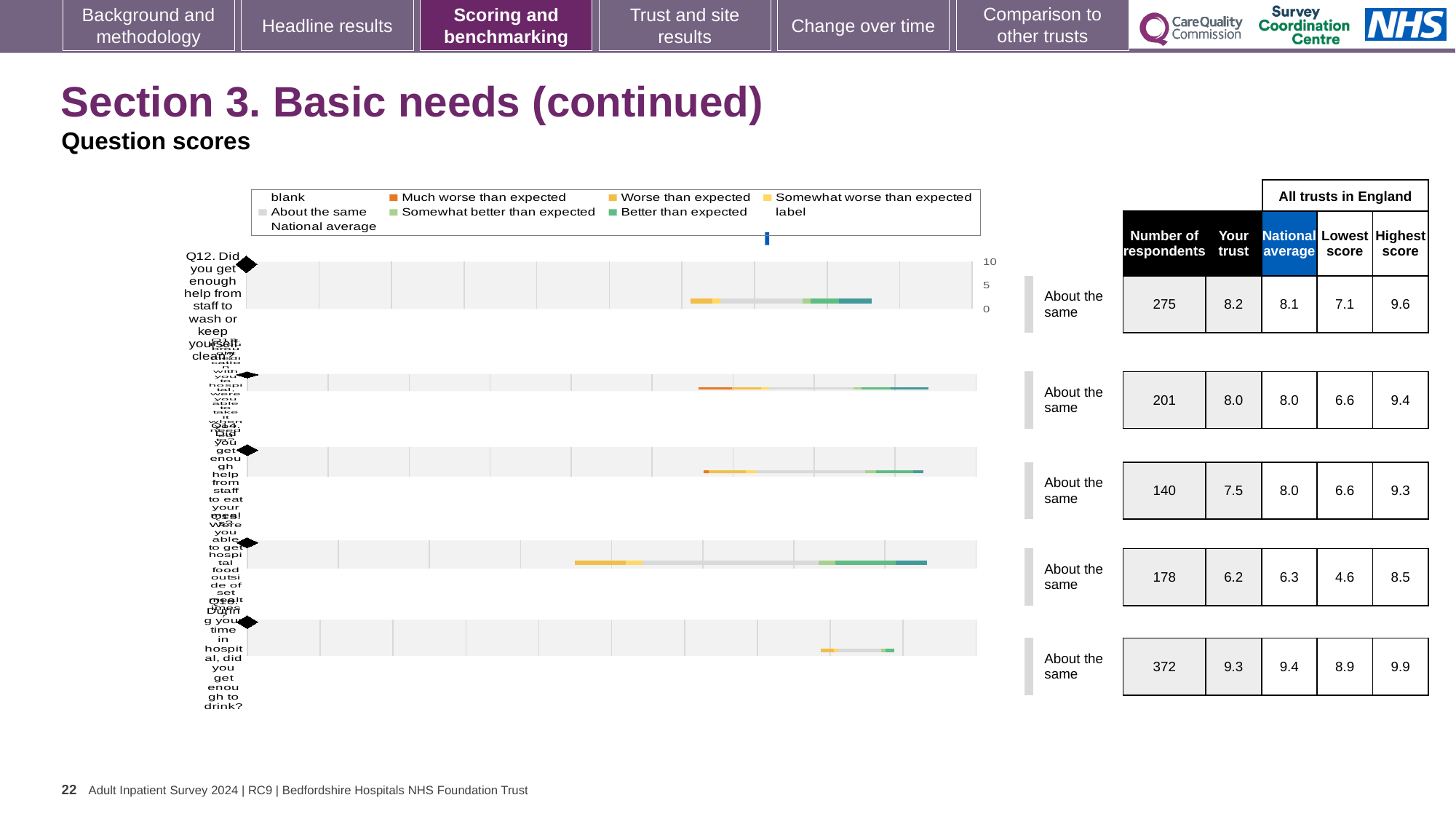
Which question row has the lowest 'Your trust' score? Q15 What is the national average for Q16 (did you get enough to drink)? 9.4 What benchmark label is shown for every question row in the chart? About the same For Q14, which is larger: the 'Your trust' score or the national average? National average What is the 'Your trust' score for Q12 (help from staff to wash or keep yourself clean)? 8.2 Which question row has the largest number of respondents? Q16 Which question row has the highest 'Your trust' score? Q16 How many respondents answered Q14 (help from staff to eat your meals)? 140 What is the difference between the highest score and the lowest score for Q12? 2.5 What kind of chart is shown on the slide? bar chart What is the title of the slide containing the chart? Section 3. Basic needs (continued) How many questions (rows) are plotted in the chart? 5